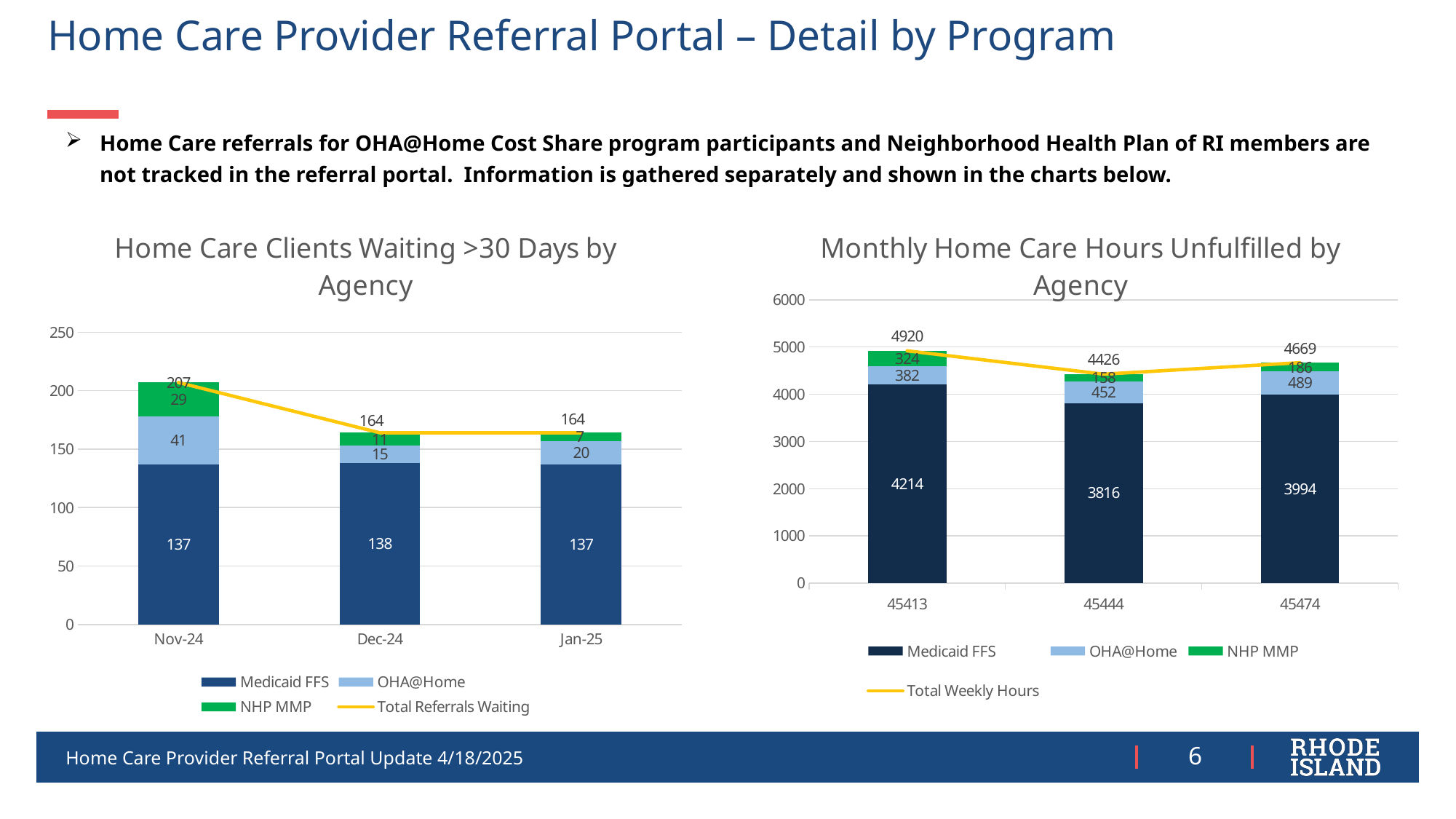
In the 'Home Care Clients Waiting >30 Days by Agency' chart, how many months are shown on the x axis? 3 In the 'Monthly Home Care Hours Unfulfilled by Agency' chart, is the OHA@Home value larger for 45413 or 45474? 45474 What type of chart is the 'Monthly Home Care Hours Unfulfilled by Agency' chart? Stacked bar chart with a line In the 'Monthly Home Care Hours Unfulfilled by Agency' chart, which category has the lowest total hours? 45444 In the 'Home Care Clients Waiting >30 Days by Agency' chart, which month has the highest total referrals waiting? Nov-24 In the 'Home Care Clients Waiting >30 Days by Agency' chart, what is the Medicaid FFS value for Dec-24? 138 In the 'Home Care Clients Waiting >30 Days by Agency' chart, what is the OHA@Home value for Nov-24? 41 In the 'Home Care Clients Waiting >30 Days by Agency' chart, what is the difference between the NHP MMP values for Nov-24 and Jan-25? 22 In the 'Home Care Clients Waiting >30 Days by Agency' chart, how many entries does the legend list? 4 In the 'Monthly Home Care Hours Unfulfilled by Agency' chart, what is the Medicaid FFS value for the category labelled 45444? 3816 In the 'Monthly Home Care Hours Unfulfilled by Agency' chart, what is the total for the category labelled 45474? 4669 In the 'Monthly Home Care Hours Unfulfilled by Agency' chart, what is the difference between the NHP MMP values for 45413 and 45444? 166